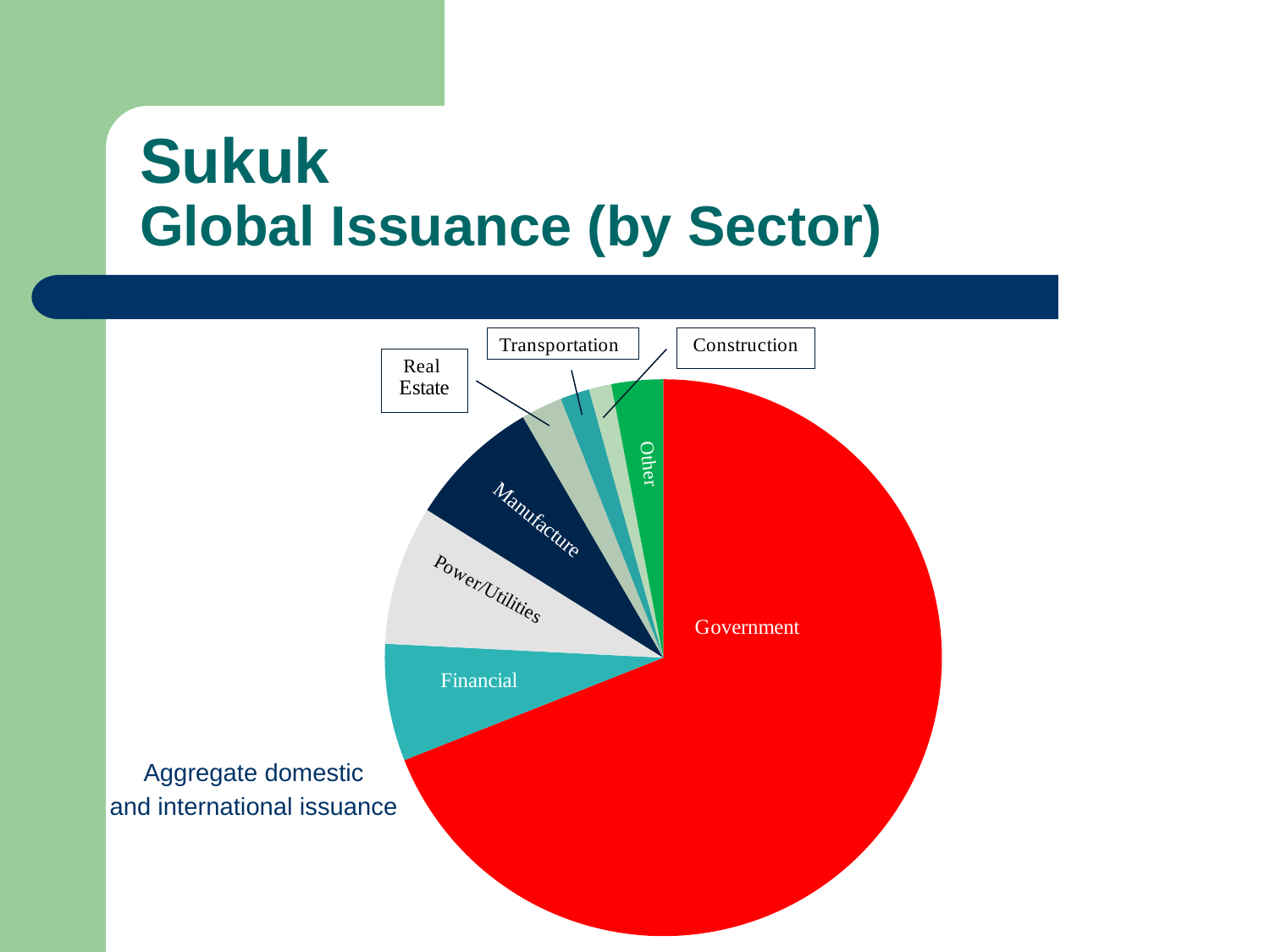
Which slice is larger, Government or Financial? Government What colour is the Government slice in the pie chart? Red How many sectors (slices) does the pie chart show? 8 What is the title of the slide containing the pie chart? Sukuk Global Issuance (by Sector) Which slice is larger, Other or Transportation? Other What kind of chart is shown on the slide? Pie chart Which sector has the largest share of global Sukuk issuance in the pie chart? Government Which slice is larger, Financial or Real Estate? Financial